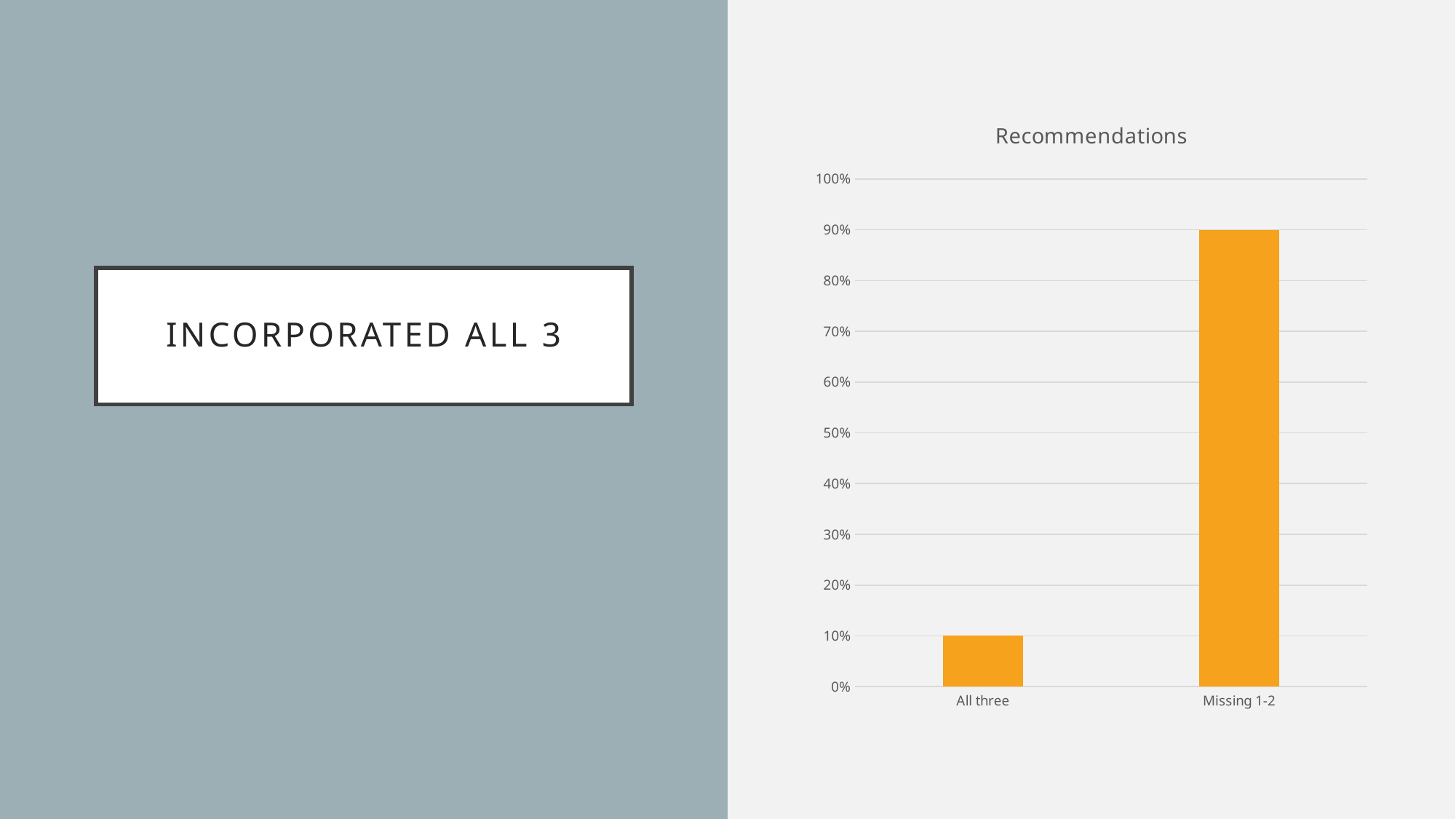
Is the value for All three greater or less than 20%? less What is the value for Missing 1-2? 90% What kind of chart is shown on the slide? Bar chart How many categories are shown on the x axis of the chart? 2 Which category has the highest value? Missing 1-2 Is the value for Missing 1-2 greater or less than 50%? greater What colour are the bars in the chart? Orange What is the title of the chart? Recommendations What is the value for All three? 10% Which category has the lowest value? All three Which is larger, the value for All three or the value for Missing 1-2? Missing 1-2 What is the difference between the value for Missing 1-2 and the value for All three? 80%